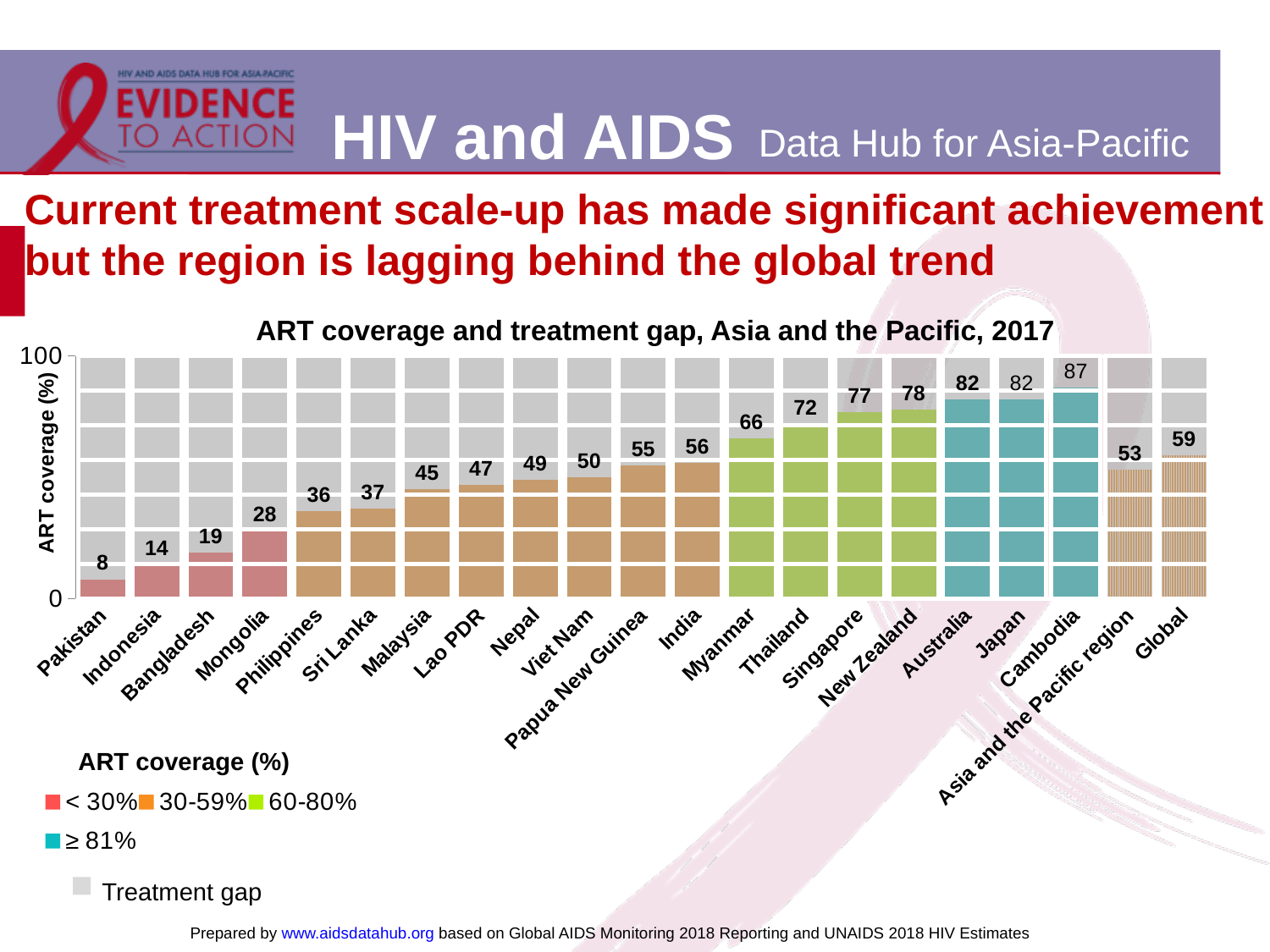
How many categories (bars) are shown on the x axis of the chart? 21 What is the ART coverage value shown for Pakistan? 8 Which country has the highest ART coverage in the chart? Cambodia What is the title of the chart? ART coverage and treatment gap, Asia and the Pacific, 2017 What is the difference between the Global ART coverage and the Asia and the Pacific region ART coverage? 6 What is the ART coverage value shown for Thailand? 72 How many entries does the legend list? 5 What kind of chart is shown on the slide? Stacked bar chart Which country has the lowest ART coverage in the chart? Pakistan What is the difference in ART coverage between Cambodia and Pakistan? 79 What is the ART coverage value shown for the Asia and the Pacific region? 53 Which has higher ART coverage, Myanmar or India? Myanmar